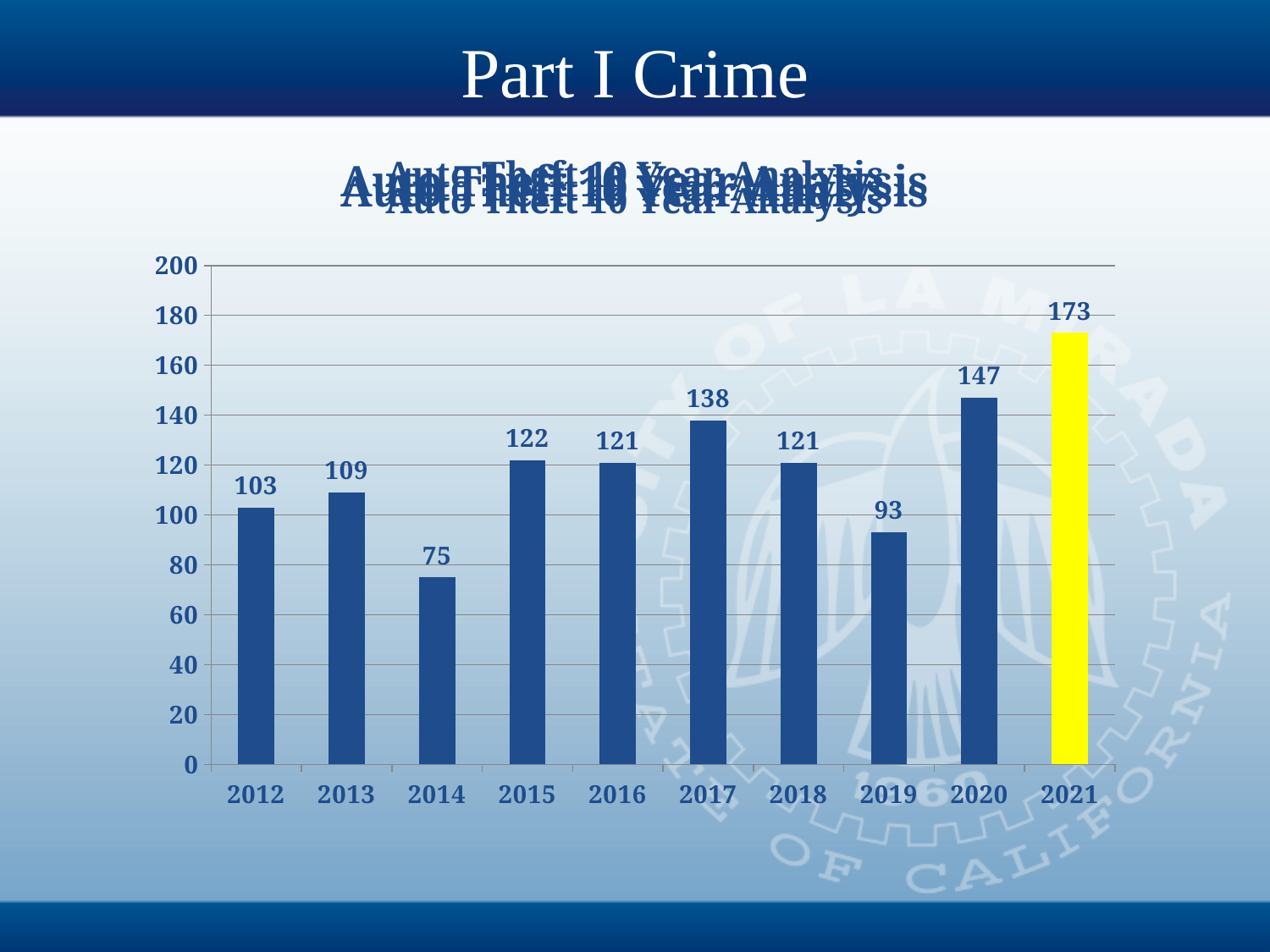
How many years are shown on the x axis? 10 What is the value for 2020? 147 Which bar is coloured yellow instead of blue? 2021 What is the difference between the values for 2019 and 2014? 18 What is the value for 2017? 138 Which year has the highest value? 2021 Which is larger, the value for 2013 or the value for 2019? 2013 What is the value for 2014? 75 Which year has the lowest value? 2014 What kind of chart is shown on the slide? bar chart Is the value for 2021 greater or less than 160? greater What is the difference between the values for 2021 and 2020? 26